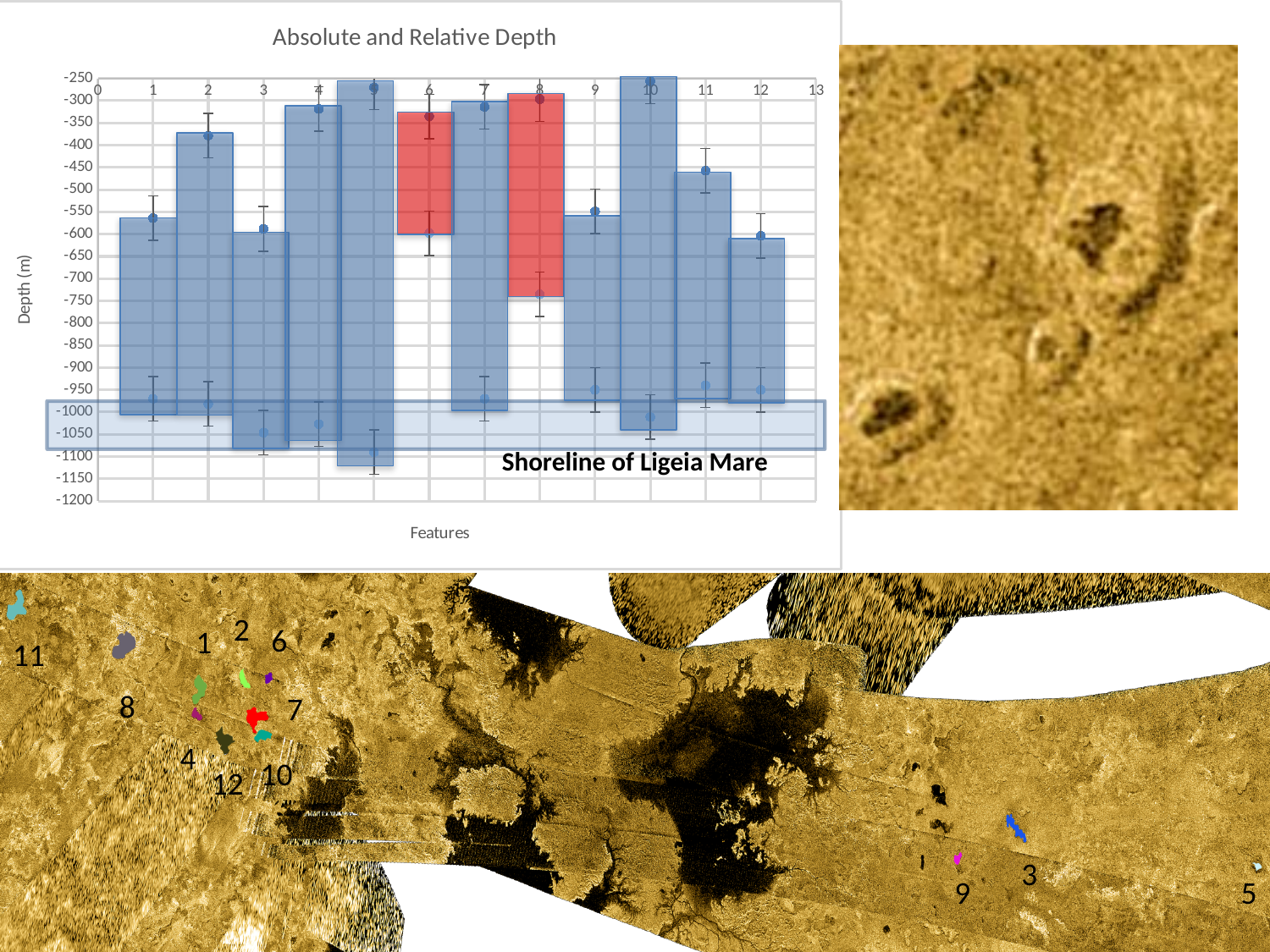
Which feature's bar extends to the deepest (lowest) depth value? 5 Which feature has the smallest depth range (shortest bar)? 6 Is the upper value of the bar for feature 11 greater or less than -500? greater What type of chart is shown on the slide? bar chart Is the lower value of the bar for feature 6 greater or less than -700? greater Which feature has the deeper (lower) bottom value, feature 8 or feature 9? 9 Is the upper value of the bar for feature 1 greater or less than -500? less Which feature has the shallower (higher) upper depth value, feature 2 or feature 3? 2 What is the title of the chart? Absolute and Relative Depth How many features are plotted on the x axis of the chart? 12 What is the label of the y axis of the chart? Depth (m)